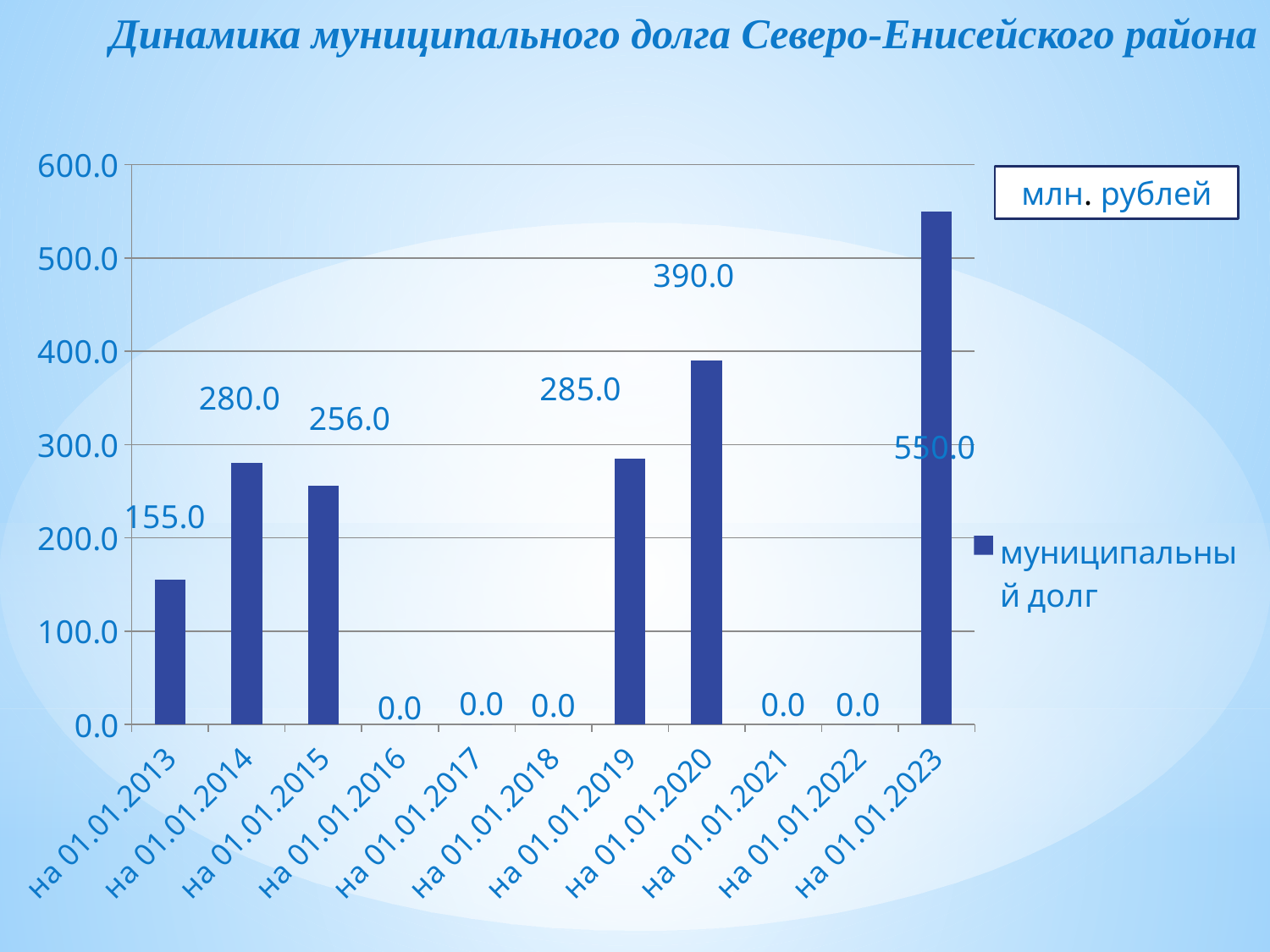
What is the value of municipal debt on 01.01.2015? 256.0 What kind of chart is shown on the slide? bar chart Is the value for 01.01.2023 greater or less than 500.0? greater Which is larger: the municipal debt on 01.01.2014 or on 01.01.2019? на 01.01.2019 What is the difference between the municipal debt on 01.01.2023 and on 01.01.2020? 160.0 What is the value of municipal debt on 01.01.2020? 390.0 What is the value of municipal debt on 01.01.2013? 155.0 How many series does the legend list? 1 Which date has the highest municipal debt? на 01.01.2023 What is the difference between the municipal debt on 01.01.2014 and on 01.01.2015? 24.0 What unit of measurement is indicated on the chart? млн. рублей How many dates are shown on the x axis? 11